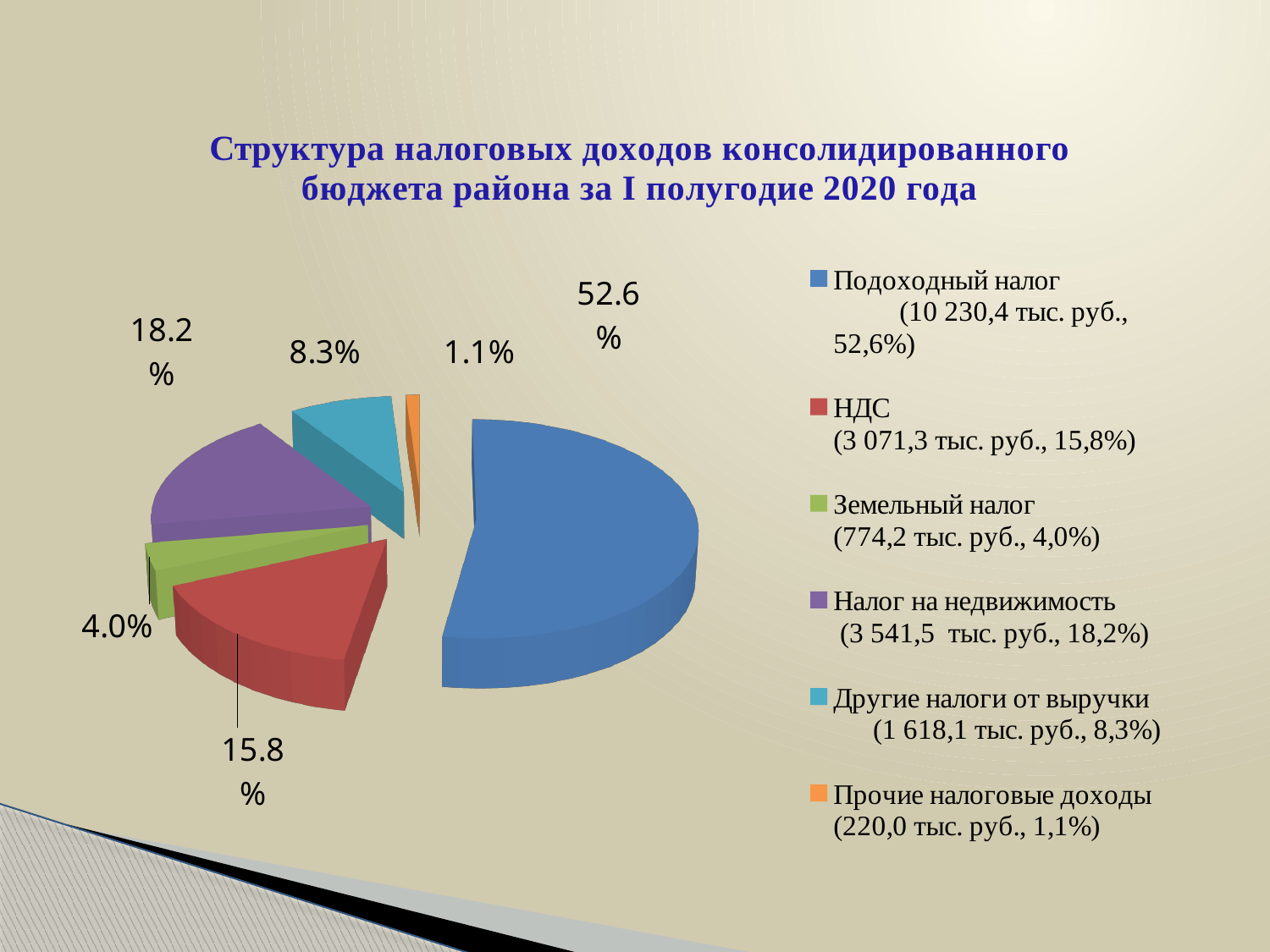
According to the legend, what amount in thousand rubles is given for Земельный налог? 774,2 тыс. руб. Which category has the smallest slice of the pie? Прочие налоговые доходы What share of the pie does Прочие налоговые доходы have? 1.1% What is the difference in percentage points between the share for Подоходный налог and the share for НДС? 36.8 What kind of chart is shown on the slide? Pie chart How many slices does the pie chart have? 6 What share of the pie does НДС have? 15.8% Which category has the largest slice of the pie? Подоходный налог What share of the pie does Подоходный налог have? 52.6% How many entries does the legend list? 6 Which is larger: the share for НДС or the share for Налог на недвижимость? Налог на недвижимость